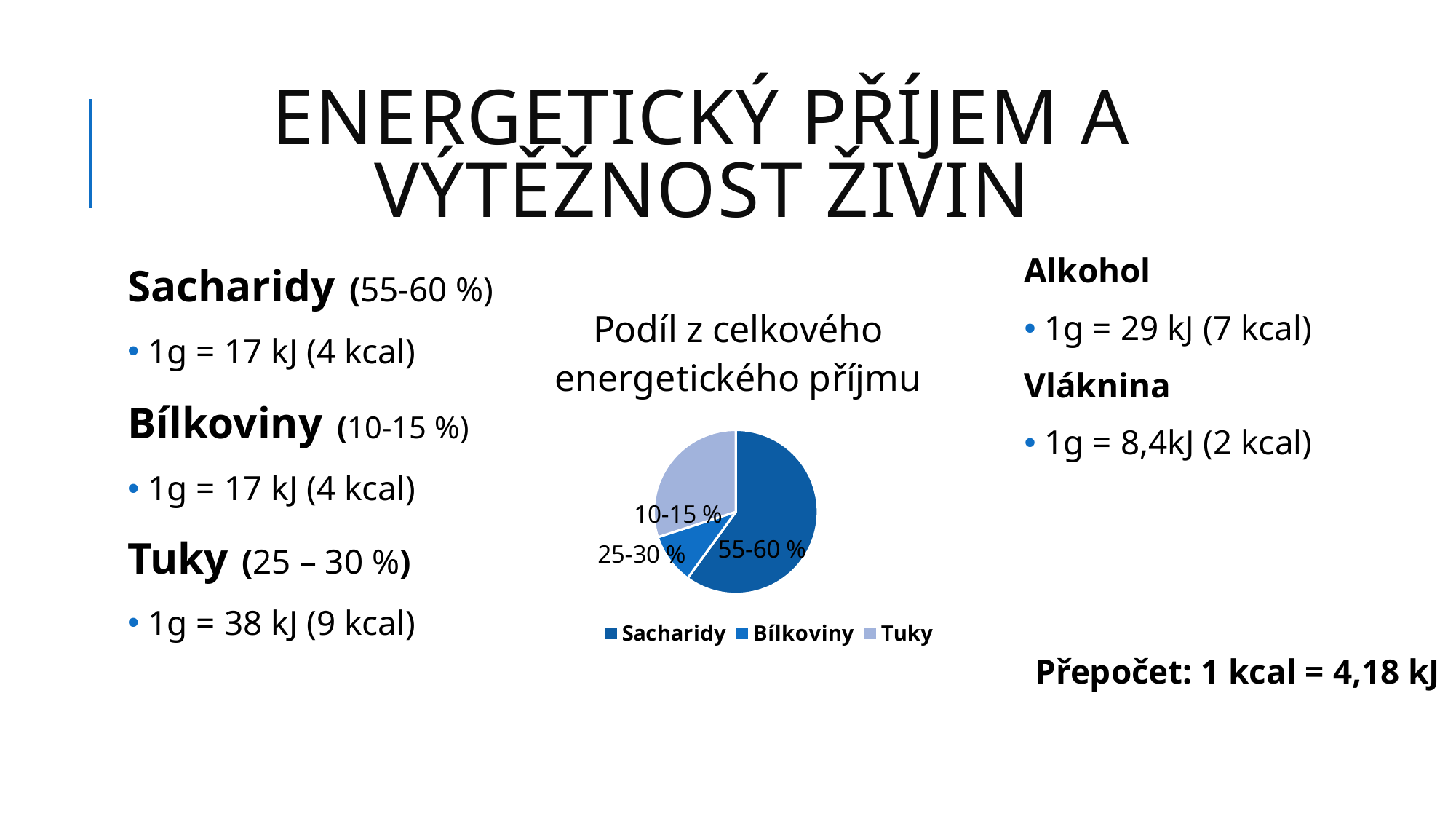
What is the title of the pie chart? Podíl z celkového energetického příjmu Which slice is larger in the pie chart, Tuky or Bílkoviny? Tuky What kind of chart is shown on the slide? pie chart Which legend entry is shown in the lightest blue colour? Tuky What share of the pie is labelled for Sacharidy? 55-60 % How many entries does the pie chart's legend list? 3 Which category has the largest slice in the pie chart? Sacharidy Which category has the smallest slice in the pie chart? Bílkoviny Which slice is larger in the pie chart, Sacharidy or Tuky? Sacharidy How many slices does the pie chart have? 3